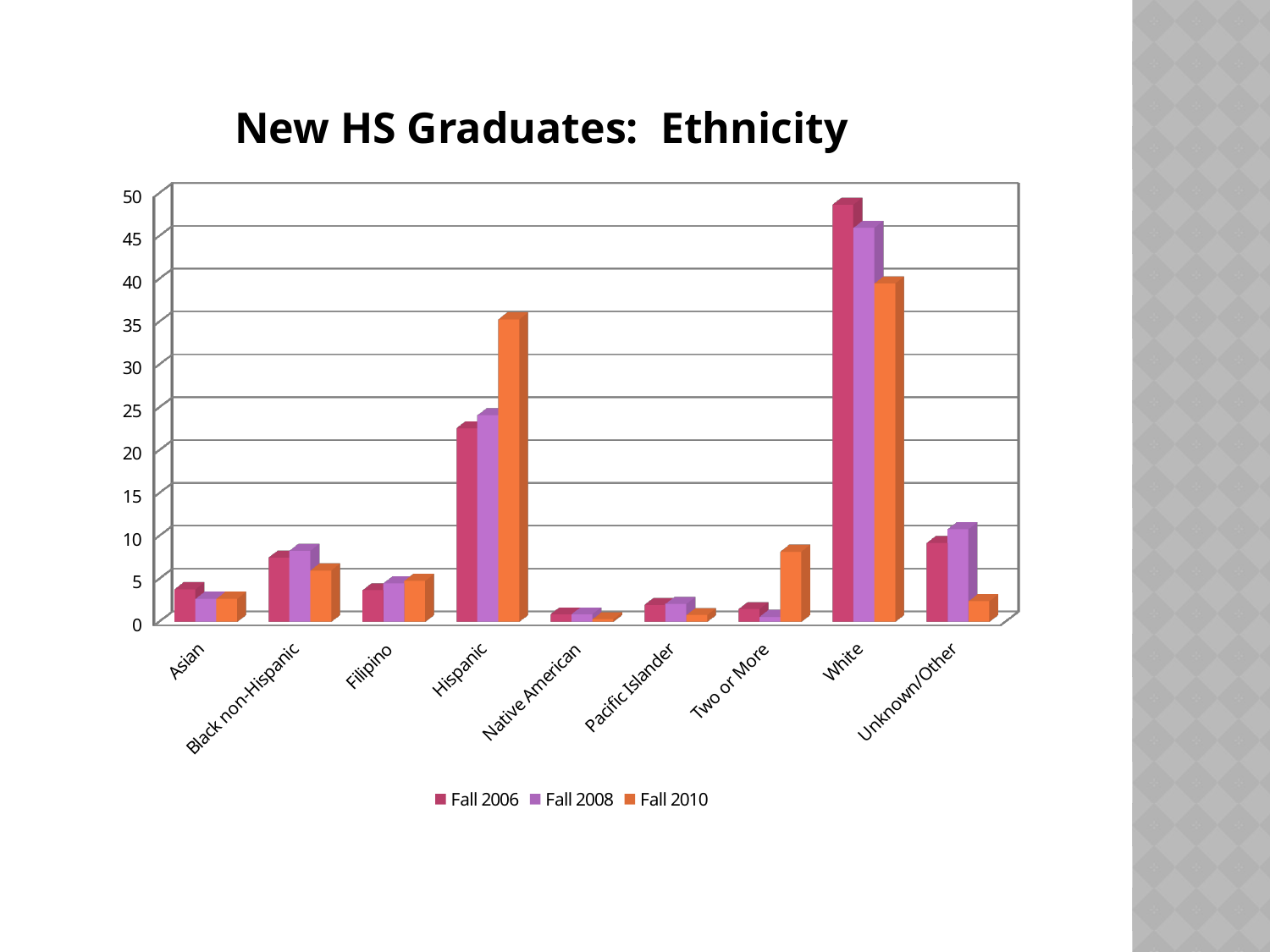
Do the values for White rise or fall from Fall 2006 to Fall 2010? fall Do the values for Hispanic rise or fall from Fall 2006 to Fall 2010? rise What kind of chart is shown on the slide? bar chart Is the Fall 2010 value for Hispanic greater or less than 30? greater How many ethnicity categories are shown on the x axis? 9 What is the title of the chart? New HS Graduates: Ethnicity For Hispanic, which is larger: the Fall 2006 value or the Fall 2010 value? Fall 2010 For Two or More, which is larger: the Fall 2006 value or the Fall 2010 value? Fall 2010 Is the Fall 2010 value for White greater or less than 35? greater How many series does the legend list? 3 Is the Fall 2008 value for Black non-Hispanic greater or less than 10? less Which ethnicity category has the highest Fall 2006 value? White